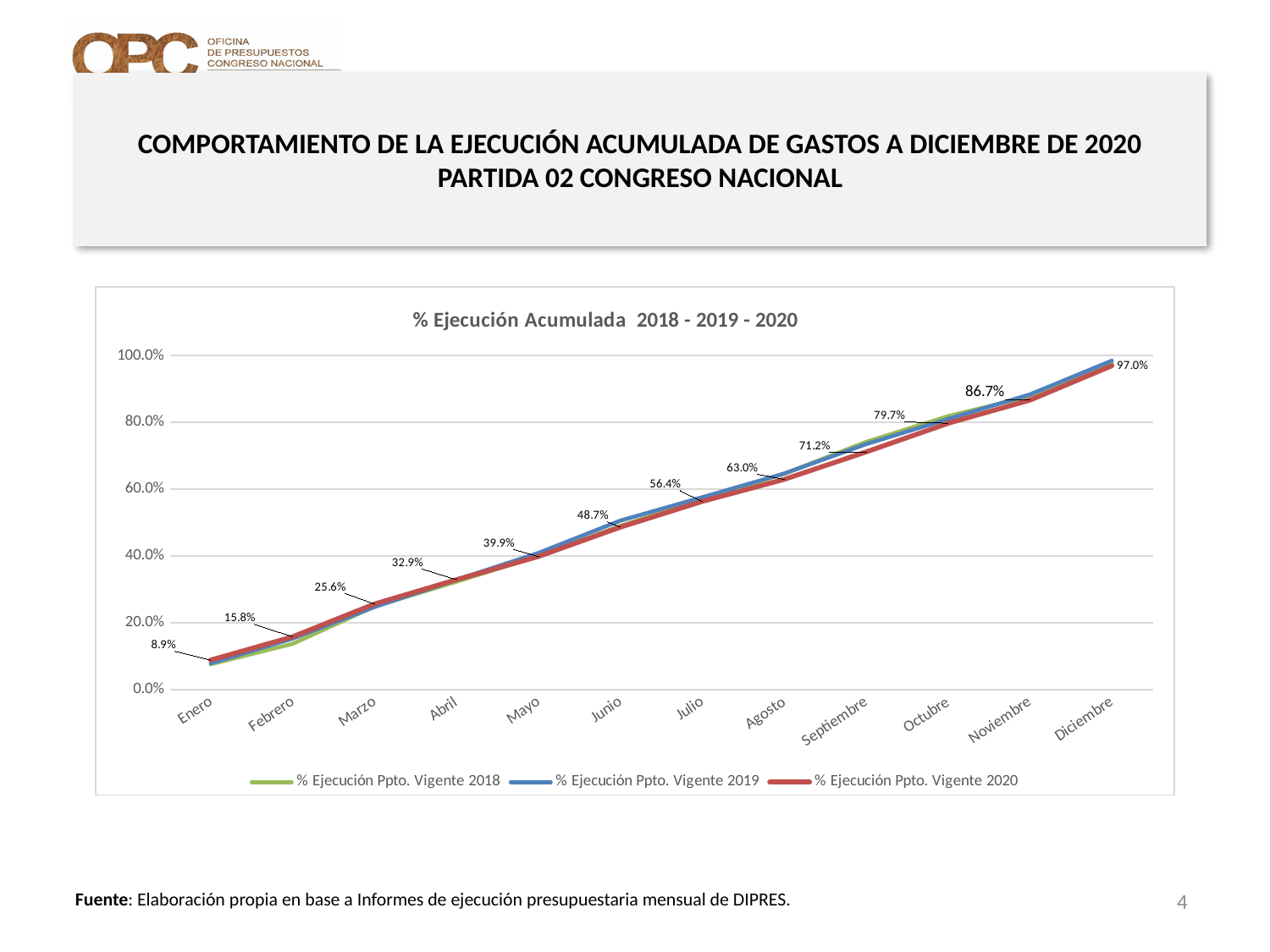
What is the labelled value for % Ejecución Ppto. Vigente 2020 in Enero? 8.9% In which month is the labelled 2020 value lowest? Enero Do the values rise or fall from Enero to Diciembre? rise How many months are plotted along the x axis? 12 What kind of chart is shown on the slide? line chart How many series does the legend list? 3 What is the title of the chart? % Ejecución Acumulada 2018 - 2019 - 2020 What is the labelled value for % Ejecución Ppto. Vigente 2020 in Noviembre? 86.7% By how many percentage points does the labelled 2020 value increase from Noviembre to Diciembre? 10.3% What is the labelled value for % Ejecución Ppto. Vigente 2020 in Junio? 48.7% What is the labelled value for % Ejecución Ppto. Vigente 2020 in Diciembre? 97.0% In which month is the labelled 2020 value highest? Diciembre